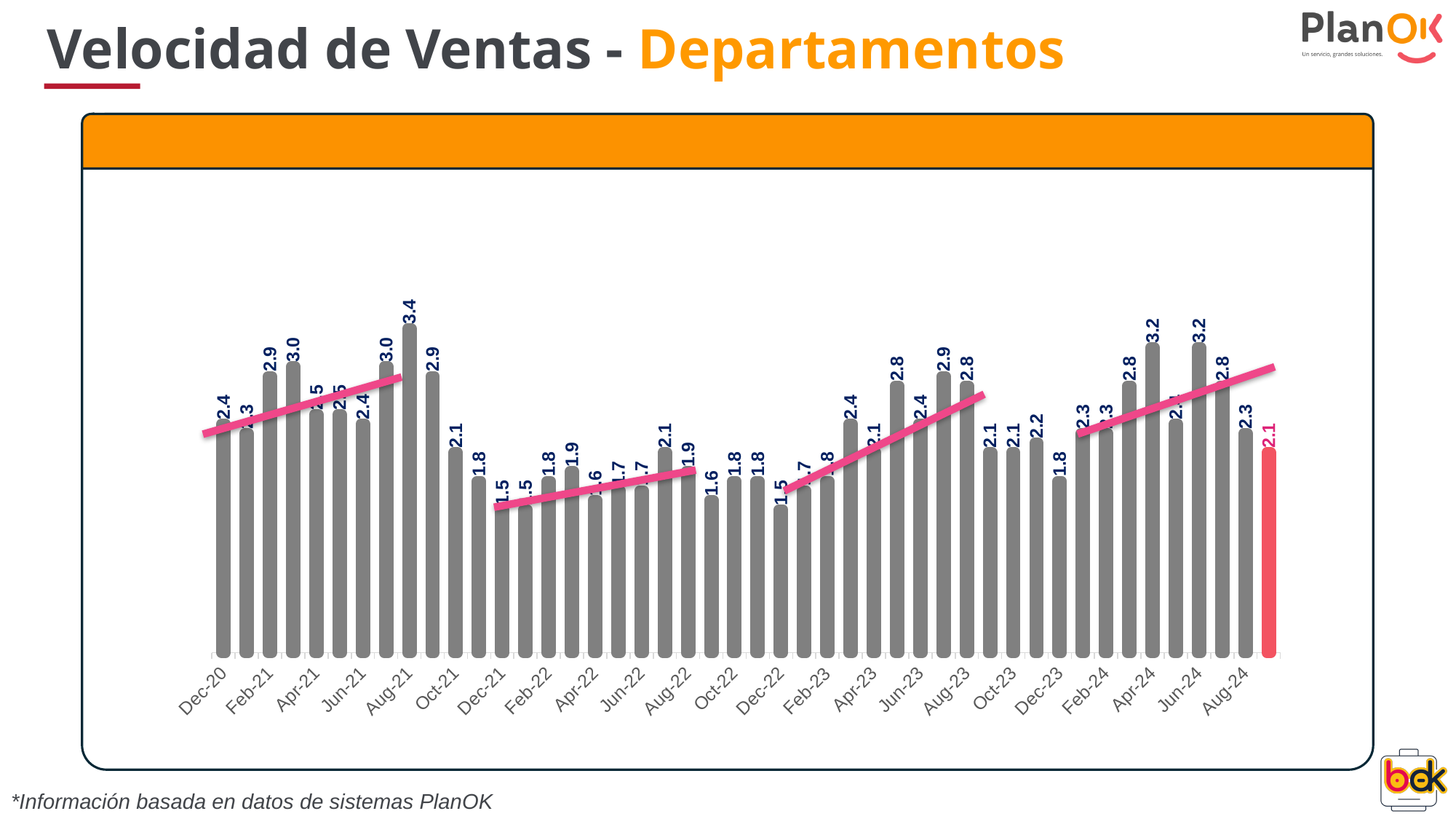
What is the value for Apr-24? 3.2 What kind of chart is shown on the slide? Bar chart What is the value of the red (last) bar on the chart? 2.1 What is the value for Dec-20? 2.4 What is the value for Dec-23? 1.8 What is the difference between the values for Aug-21 and Dec-21? 1.9 Which is larger, the value for Aug-21 or the value for Apr-24? Aug-21 What is the value for Aug-24? 2.3 Which month has the highest value? Aug-21 What is the value for Dec-21? 1.5 What is the value for Aug-21? 3.4 What is the lowest value shown on the chart? 1.5